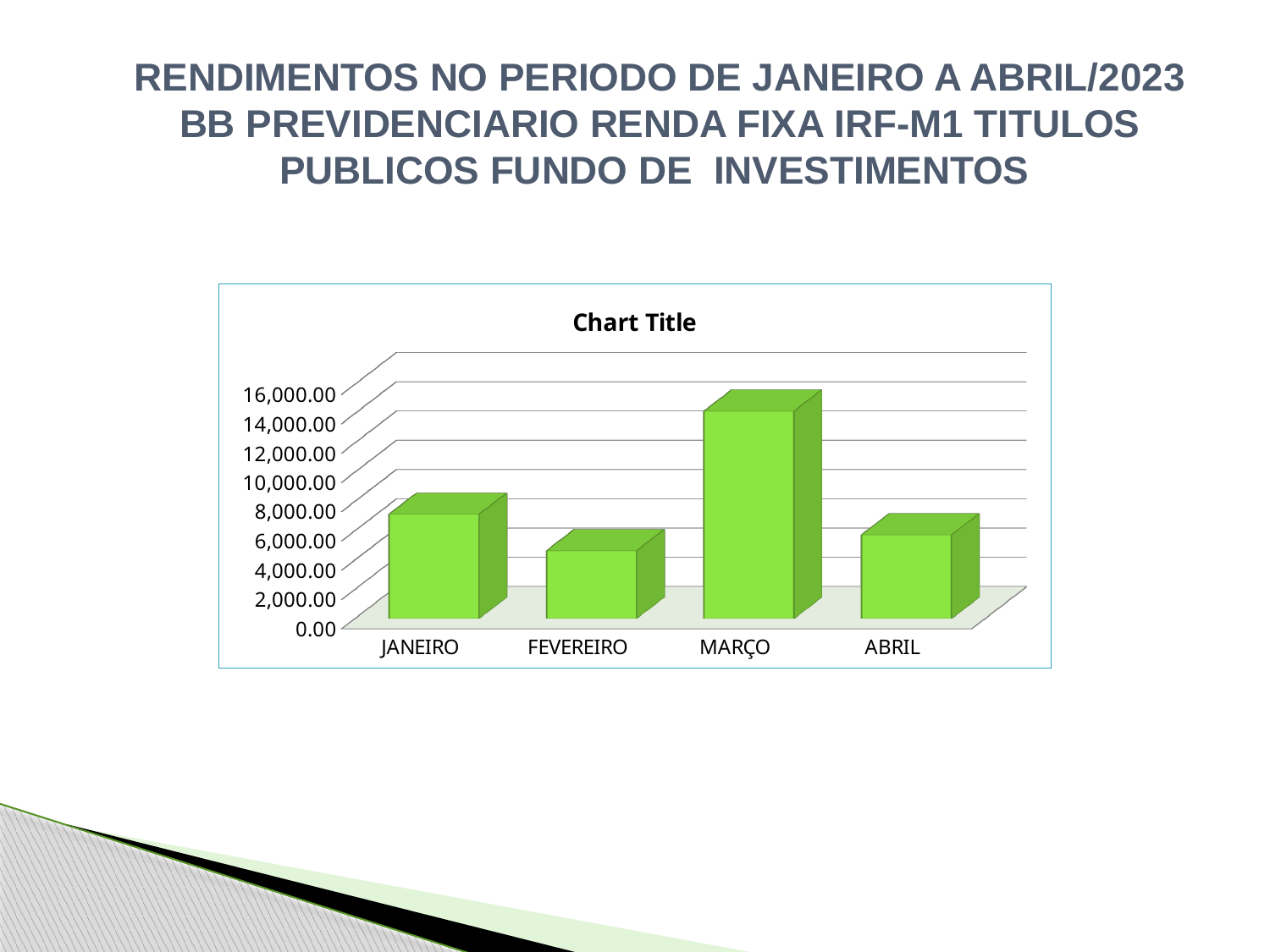
Does the value rise or fall from FEVEREIRO to MARÇO? rise Which has the larger value, JANEIRO or ABRIL? JANEIRO Which month has the highest value in the chart? MARÇO Is the value for JANEIRO greater or less than 6,000.00? greater Is the value for MARÇO greater or less than 12,000.00? greater How many categories are shown on the x axis of the chart? 4 Is the value for ABRIL greater or less than 10,000.00? less What kind of chart is shown on the slide? bar chart Which month has the lowest value in the chart? FEVEREIRO What title is printed above the chart's plot area? Chart Title Which has the larger value, MARÇO or FEVEREIRO? MARÇO